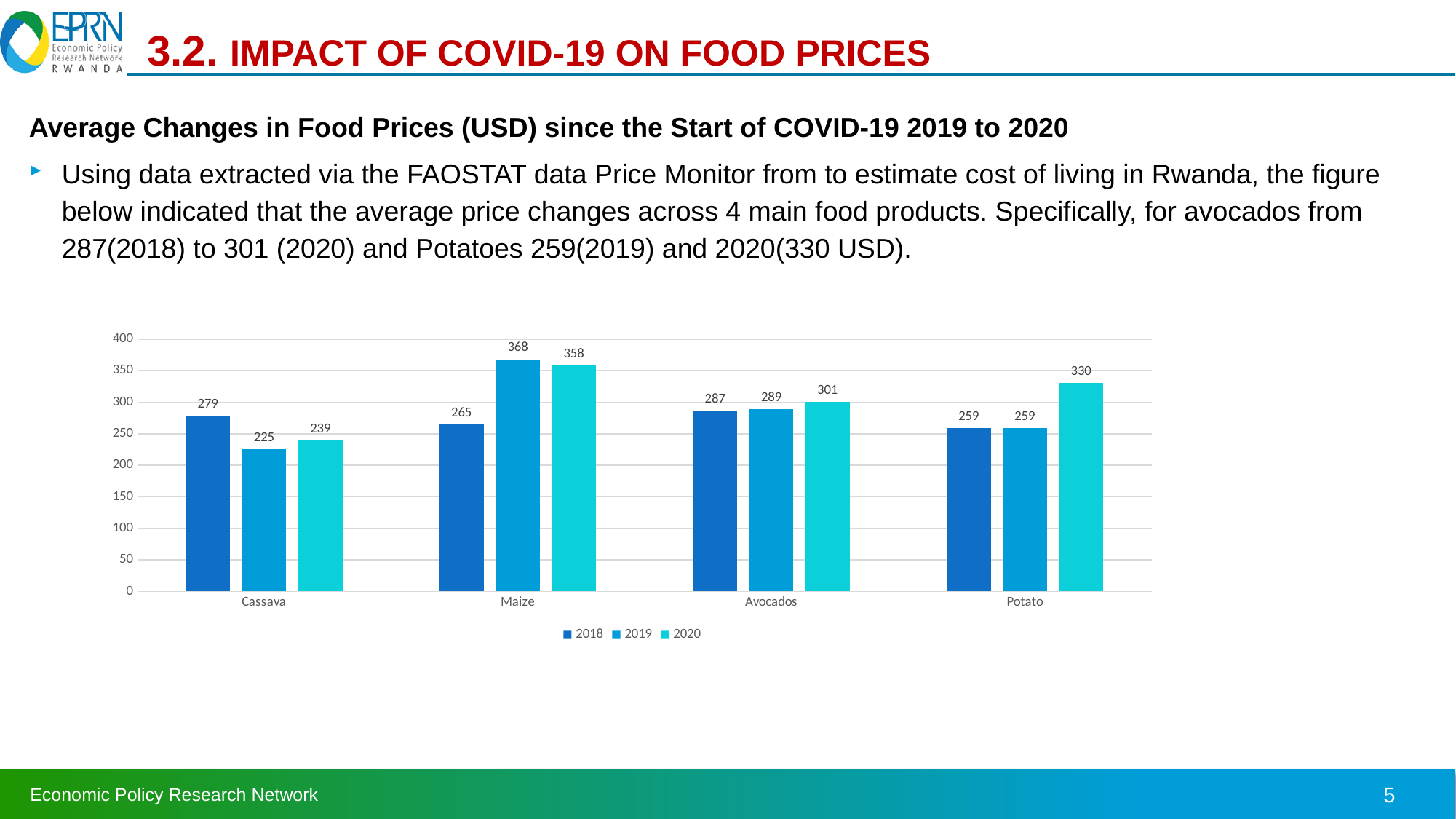
What is the difference between the 2020 and 2018 values for Potato? 71 Which category has the highest 2020 value? Maize How many food categories are shown on the x axis? 4 What is the 2019 value for Maize? 368 How many series does the legend list? 3 Is the 2019 value for Cassava greater or less than 250? less What is the 2020 value for Potato? 330 Which category has the lowest 2019 value? Cassava Do the values for Avocados rise or fall from 2018 to 2020? rise What kind of chart is shown on the slide? bar chart What is the 2018 value for Cassava? 279 Which is larger, the 2019 value for Maize or the 2020 value for Maize? 2019 value for Maize